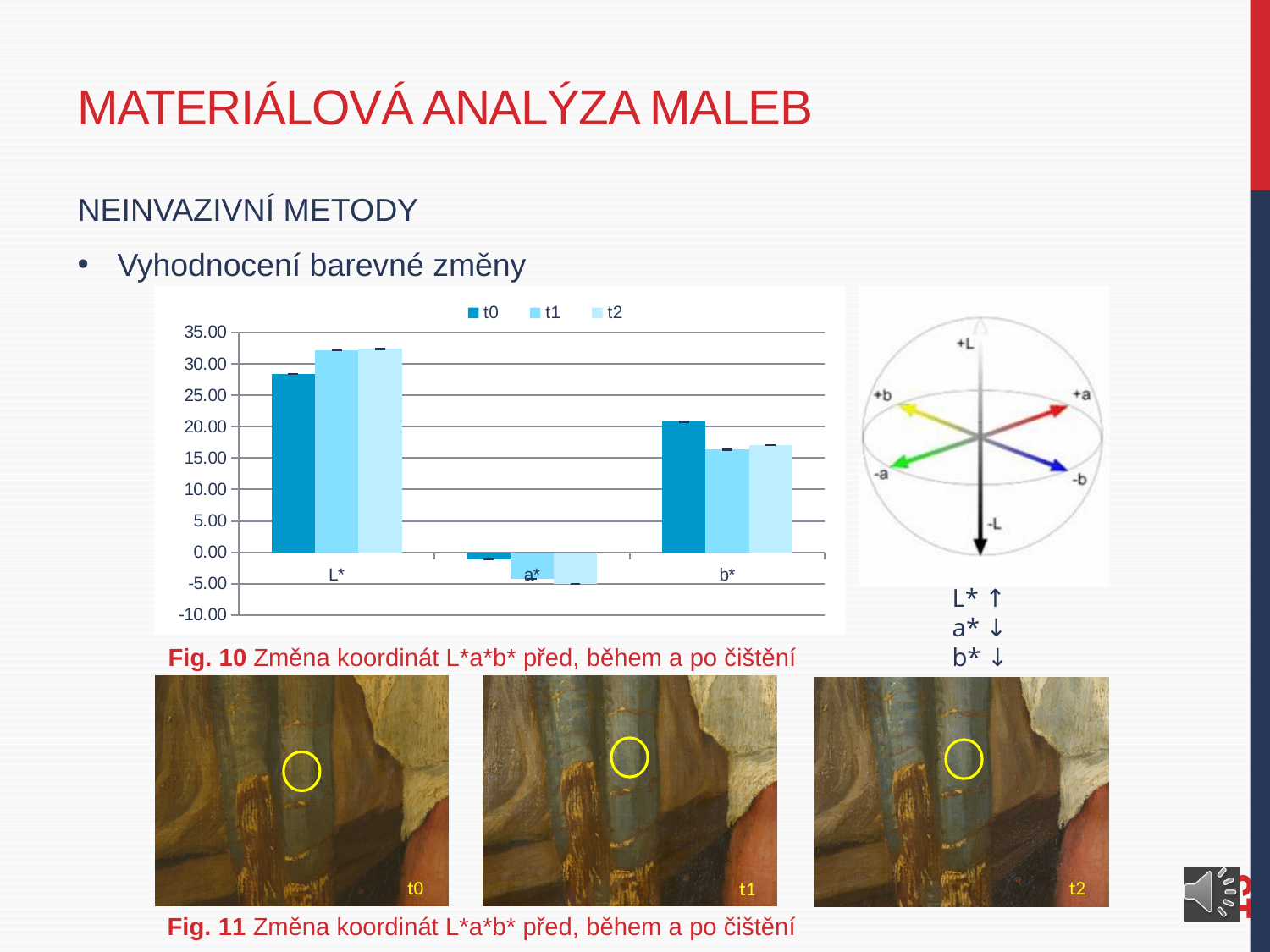
For b*, which is larger: the t0 value or the t1 value? t0 What are the series names listed in the chart legend? t0, t1, t2 How many series does the chart legend list? 3 How many categories are shown on the x axis of the chart? 3 What kind of chart is shown in Fig. 10? bar chart Is the t2 value for a* greater or less than 0.00? less Which category has the highest t0 value in the chart? L* Is the t1 value for L* greater or less than 30.00? greater Is the t0 value for L* greater or less than 25.00? greater Which category has the lowest values in the chart? a* For L*, which is larger: the t0 value or the t1 value? t1